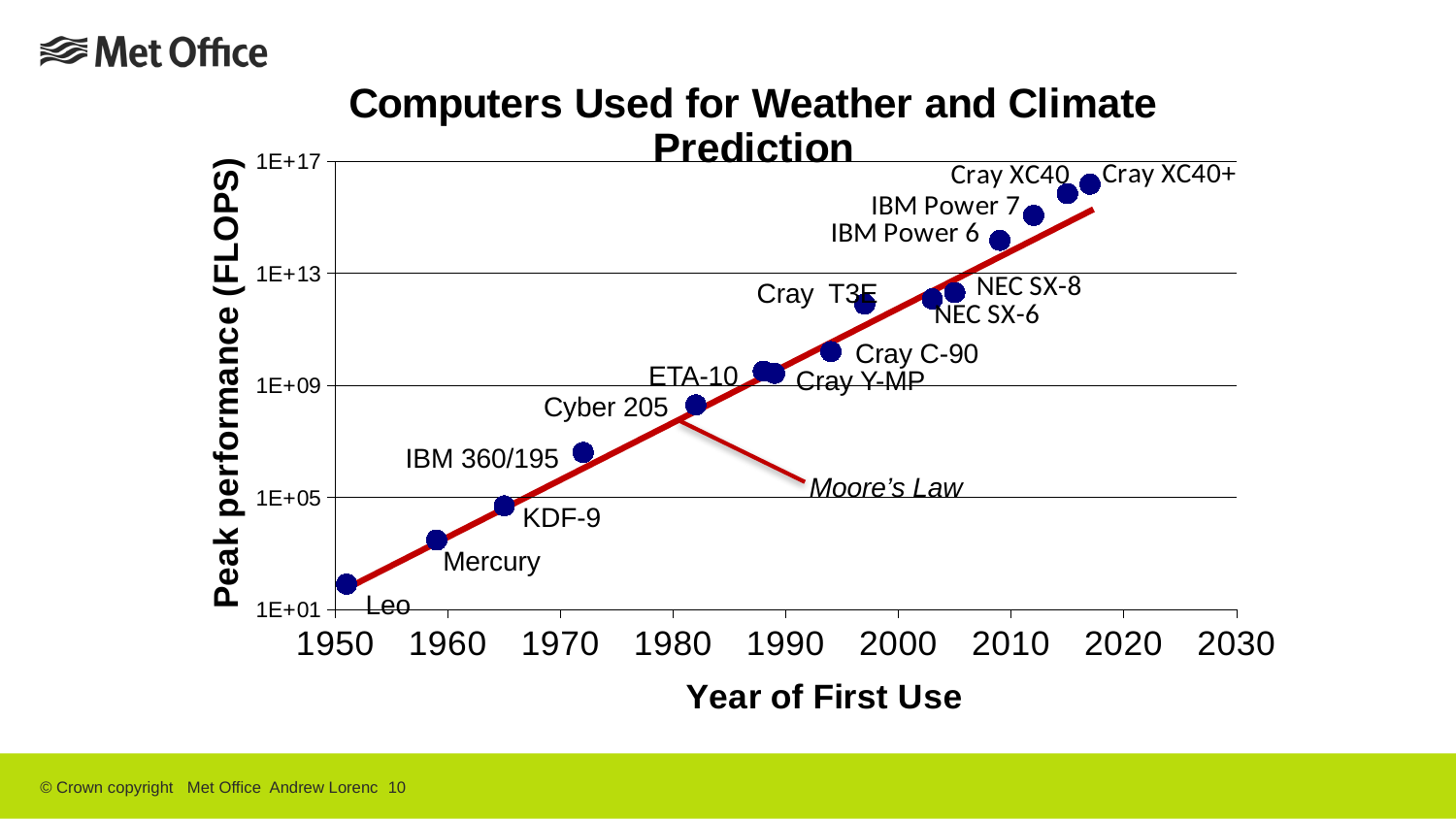
Is the peak performance for Cray XC40+ greater or less than 1E+13 FLOPS? greater Is the peak performance for Cray C-90 greater or less than 1E+09 FLOPS? greater Does peak performance rise or fall as the year of first use increases? Rises How many labelled computers are plotted on the chart? 15 Which has the higher peak performance, IBM Power 7 or KDF-9? IBM Power 7 Is the peak performance for Leo greater or less than 1E+05 FLOPS? less Which computer has the highest peak performance on the chart? Cray XC40+ What does the red line on the chart represent? Moore's Law What kind of chart is shown on the slide? Scatter chart What is the title of the chart? Computers Used for Weather and Climate Prediction Which computer has the lowest peak performance on the chart? Leo